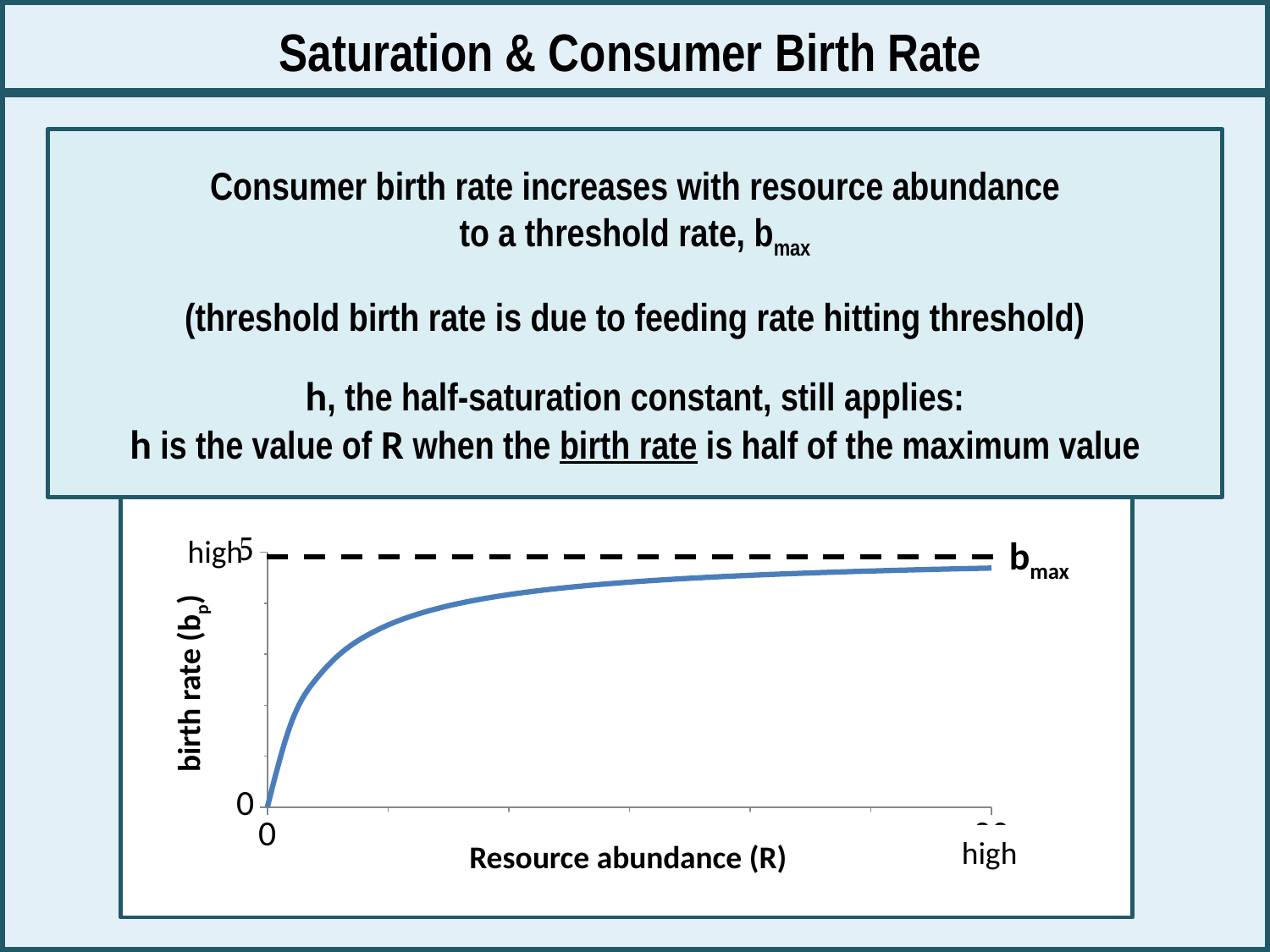
What value is shown at the origin of the x axis? 0 What kind of chart is shown on the slide? line chart Is the birth rate at the lowest resource abundance (R = 0) greater or less than the bmax line? less What is the title of the y axis of the chart? birth rate (bp) What label is shown at the top of the y axis? high What label is shown at the right end of the x axis? high Does the curve approach the dashed bmax line from below or from above? from below What is the title of the x axis of the chart? Resource abundance (R) What label is written at the right end of the dashed horizontal line? bmax Does the birth rate rise or fall as resource abundance increases along the x axis? rise How many solid curves are plotted on the chart? 1